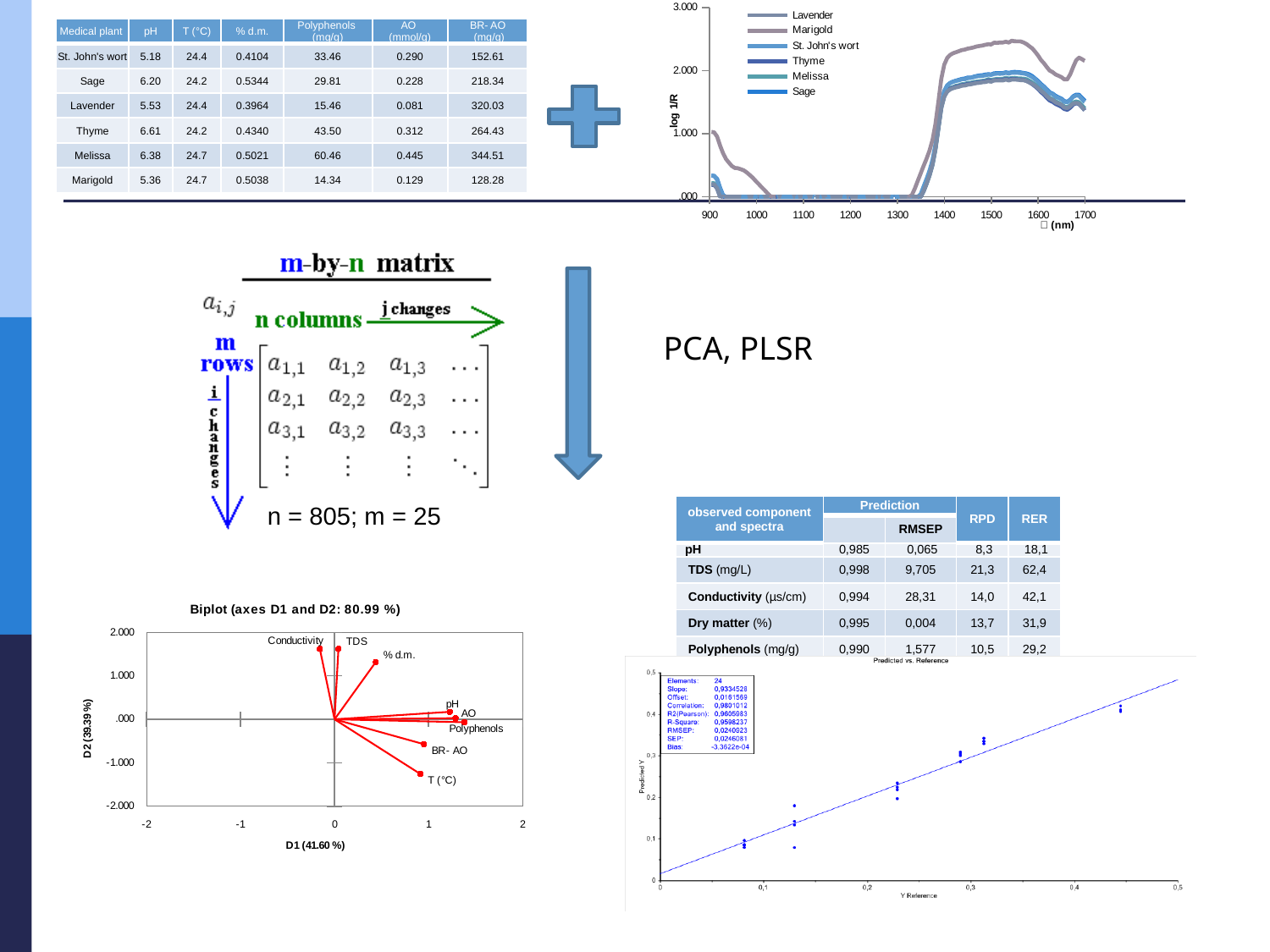
In the bottom-right Predicted vs. Reference chart, how many elements are reported in the annotation box? 24 In the bottom-right Predicted vs. Reference chart, what RMSEP value is reported in the annotation box? 0,0240923 How many series does the legend of the top-right spectral chart list? 6 What is the x-axis label of the bottom-left biplot? D1 (41.60 %) What is the title of the bottom-left biplot? Biplot (axes D1 and D2: 80.99 %) In the bottom-left biplot, which variable has the lowest D2 value? T (°C) What kind of chart is the top-right chart with the wavelength axis? line chart How many labelled variables are plotted in the bottom-left biplot? 8 In the top-right spectral chart, which series has the highest log 1/R value around 1500 nm? Marigold In the top-right spectral chart, is the Marigold value at 1200 nm greater or less than 1.000? less In the top-right spectral chart, is the Marigold value at 1500 nm greater or less than 2.000? greater In the bottom-left biplot, is the D2 value for Conductivity greater or less than 1.000? greater